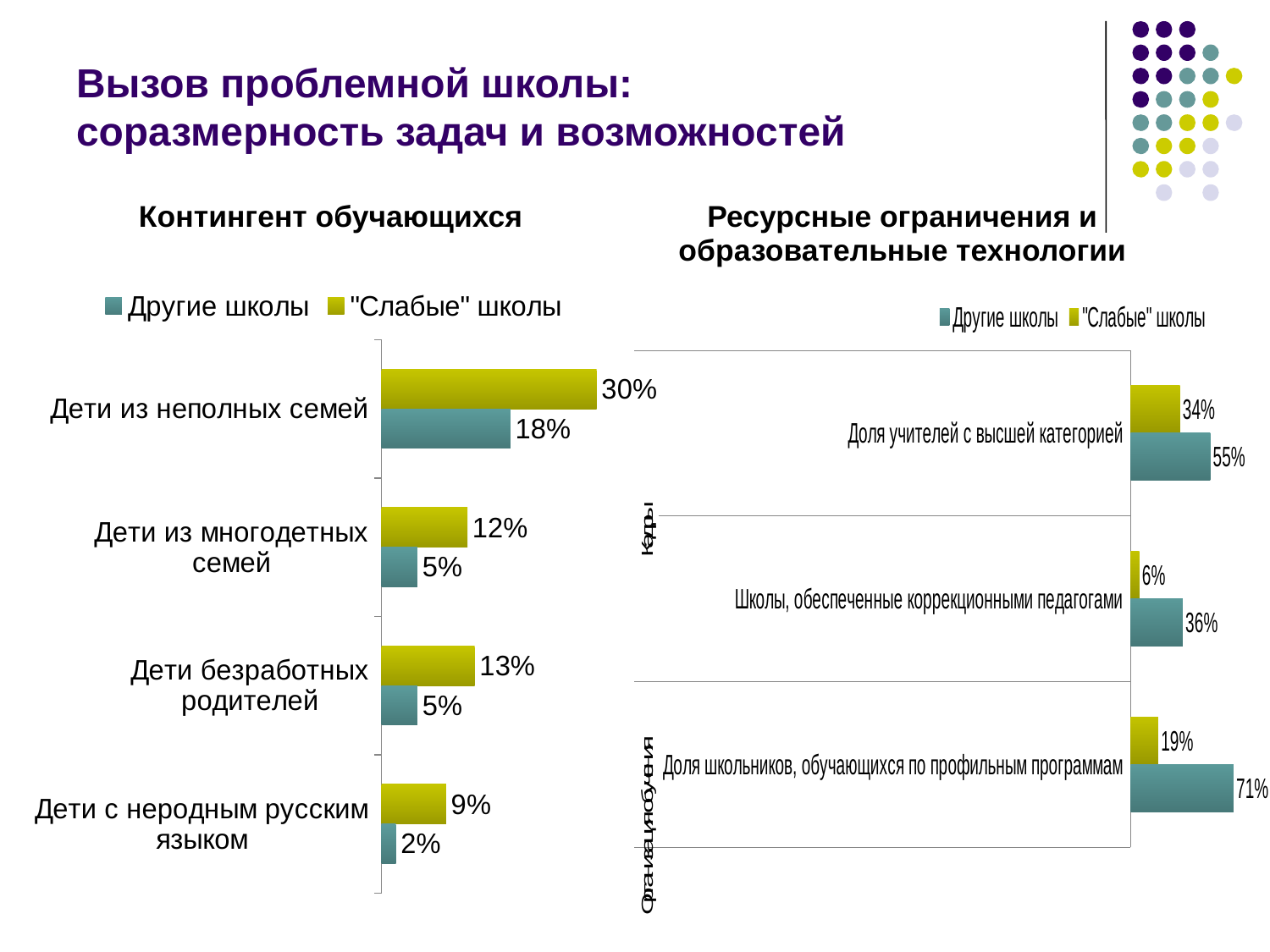
In the chart 'Ресурсные ограничения и образовательные технологии', what is the value for '"Слабые" школы' in 'Школы, обеспеченные коррекционными педагогами'? 6% In the chart 'Контингент обучающихся', which category has the highest value for '"Слабые" школы'? Дети из неполных семей In the chart 'Ресурсные ограничения и образовательные технологии', which is larger for 'Доля учителей с высшей категорией': 'Другие школы' or '"Слабые" школы'? Другие школы In the chart 'Контингент обучающихся', what is the value for '"Слабые" школы' in the category 'Дети из неполных семей'? 30% In the chart 'Контингент обучающихся', how many categories are shown? 4 In the chart 'Ресурсные ограничения и образовательные технологии', what is the difference between 'Другие школы' and '"Слабые" школы' for 'Доля учителей с высшей категорией'? 21% In the chart 'Контингент обучающихся', what is the difference between '"Слабые" школы' and 'Другие школы' for 'Дети из многодетных семей'? 7% In the chart 'Ресурсные ограничения и образовательные технологии', which category has the lowest value for '"Слабые" школы'? Школы, обеспеченные коррекционными педагогами What kind of chart is 'Ресурсные ограничения и образовательные технологии'? Bar chart In the chart 'Ресурсные ограничения и образовательные технологии', what is the value for 'Другие школы' in 'Доля школьников, обучающихся по профильным программам'? 71% In the chart 'Контингент обучающихся', what is the value for 'Другие школы' in the category 'Дети с неродным русским языком'? 2% In the chart 'Контингент обучающихся', how many series does the legend list? 2